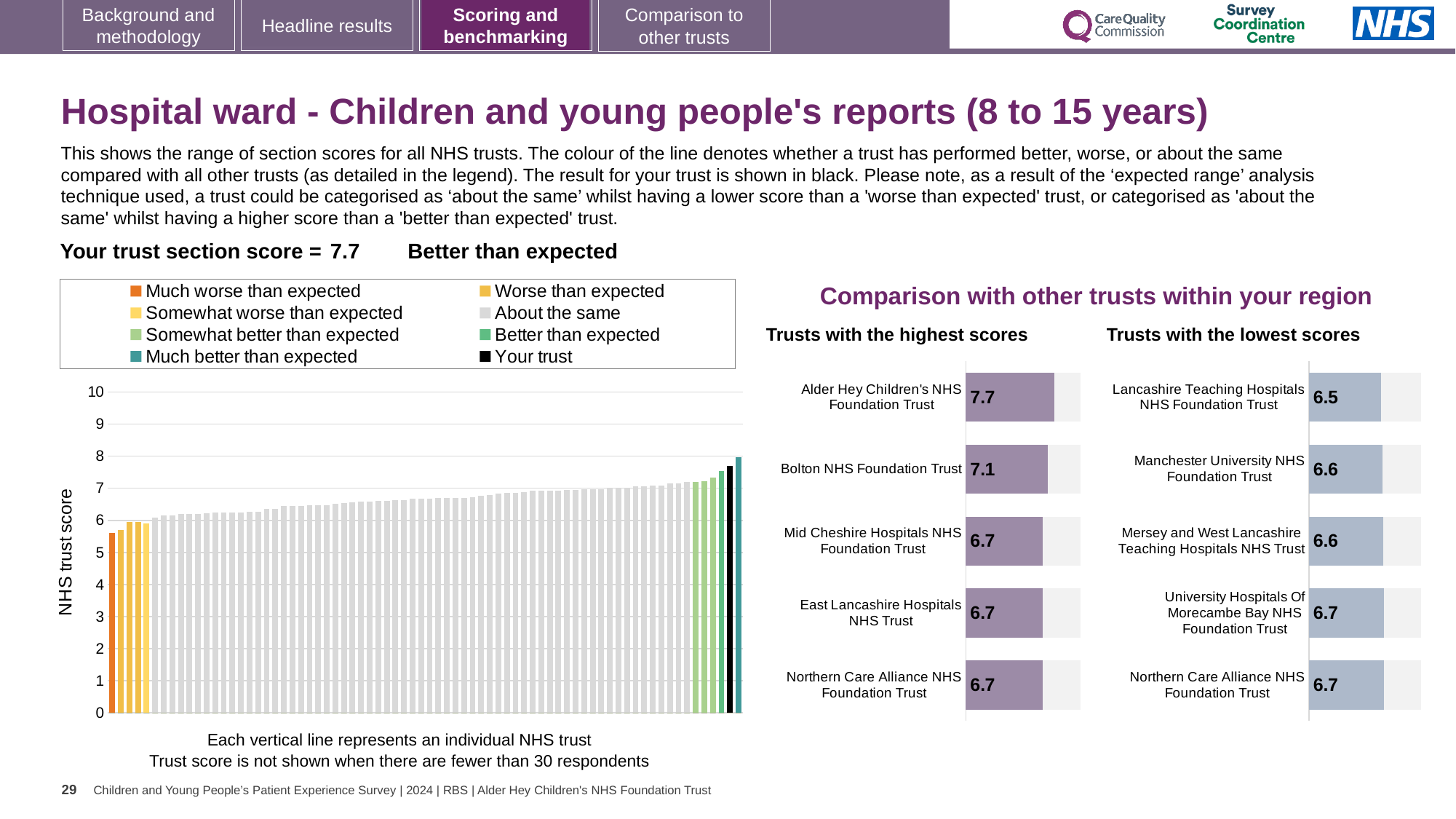
In the 'Trusts with the highest scores' chart, what is the difference between the scores of Alder Hey Children's NHS Foundation Trust and Bolton NHS Foundation Trust? 0.6 In the 'Trusts with the lowest scores' chart, what is the difference between the scores of University Hospitals Of Morecambe Bay NHS Foundation Trust and Lancashire Teaching Hospitals NHS Foundation Trust? 0.2 In the 'Trusts with the highest scores' chart, what is the score for Bolton NHS Foundation Trust? 7.1 How many entries does the legend of the NHS trust score chart on the left list? 8 In the NHS trust score chart on the left, is the value for the black 'Your trust' bar greater or less than 7? greater In the 'Trusts with the highest scores' chart, what is the score for Alder Hey Children's NHS Foundation Trust? 7.7 In the 'Trusts with the lowest scores' chart, what is the score for Manchester University NHS Foundation Trust? 6.6 In the 'Trusts with the lowest scores' chart, which trust has the lowest score? Lancashire Teaching Hospitals NHS Foundation Trust How many trusts are shown in the 'Trusts with the highest scores' chart? 5 In the 'Trusts with the highest scores' chart, which trust has the highest score? Alder Hey Children's NHS Foundation Trust Which is larger: the score for Bolton NHS Foundation Trust in the 'Trusts with the highest scores' chart or the score for Manchester University NHS Foundation Trust in the 'Trusts with the lowest scores' chart? Bolton NHS Foundation Trust In the 'Trusts with the lowest scores' chart, what is the score for Lancashire Teaching Hospitals NHS Foundation Trust? 6.5